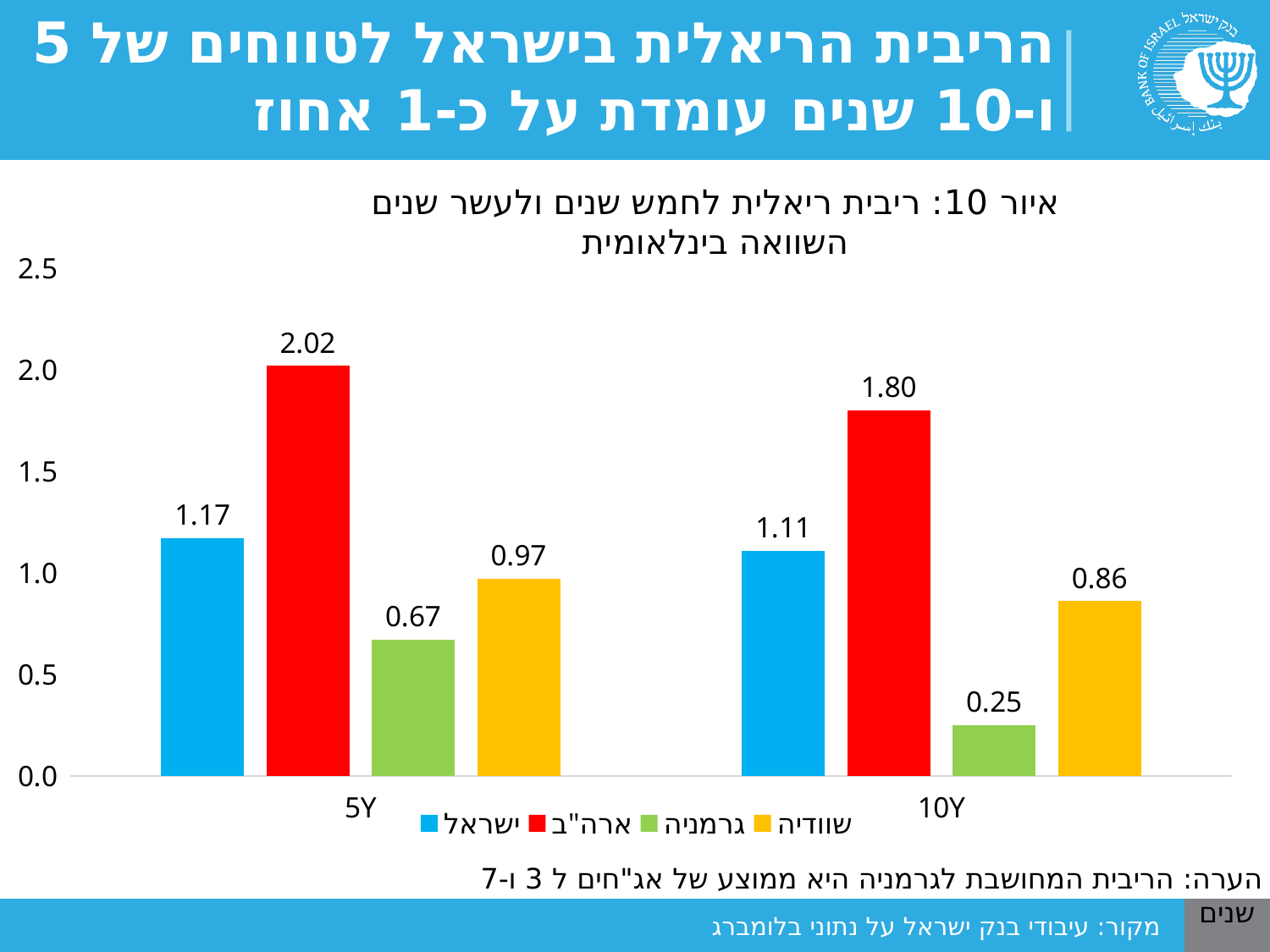
Which is larger: the value for ישראל (Israel) at 5Y or at 10Y? 5Y What is the value for שוודיה (Sweden) at 5Y? 0.97 Which series has the lowest value at 10Y? גרמניה Which series has the highest value at 5Y? ארה"ב What is the value for ארה"ב (US) at 10Y? 1.80 What is the value for ישראל (Israel) at 5Y? 1.17 How many categories are shown on the x axis? 2 What is the value for גרמניה (Germany) at 10Y? 0.25 Which colour represents ארה"ב (US) in the chart? Red What is the difference between the ארה"ב (US) values at 5Y and 10Y? 0.22 What kind of chart is shown on the slide? Bar chart How many series does the legend list? 4